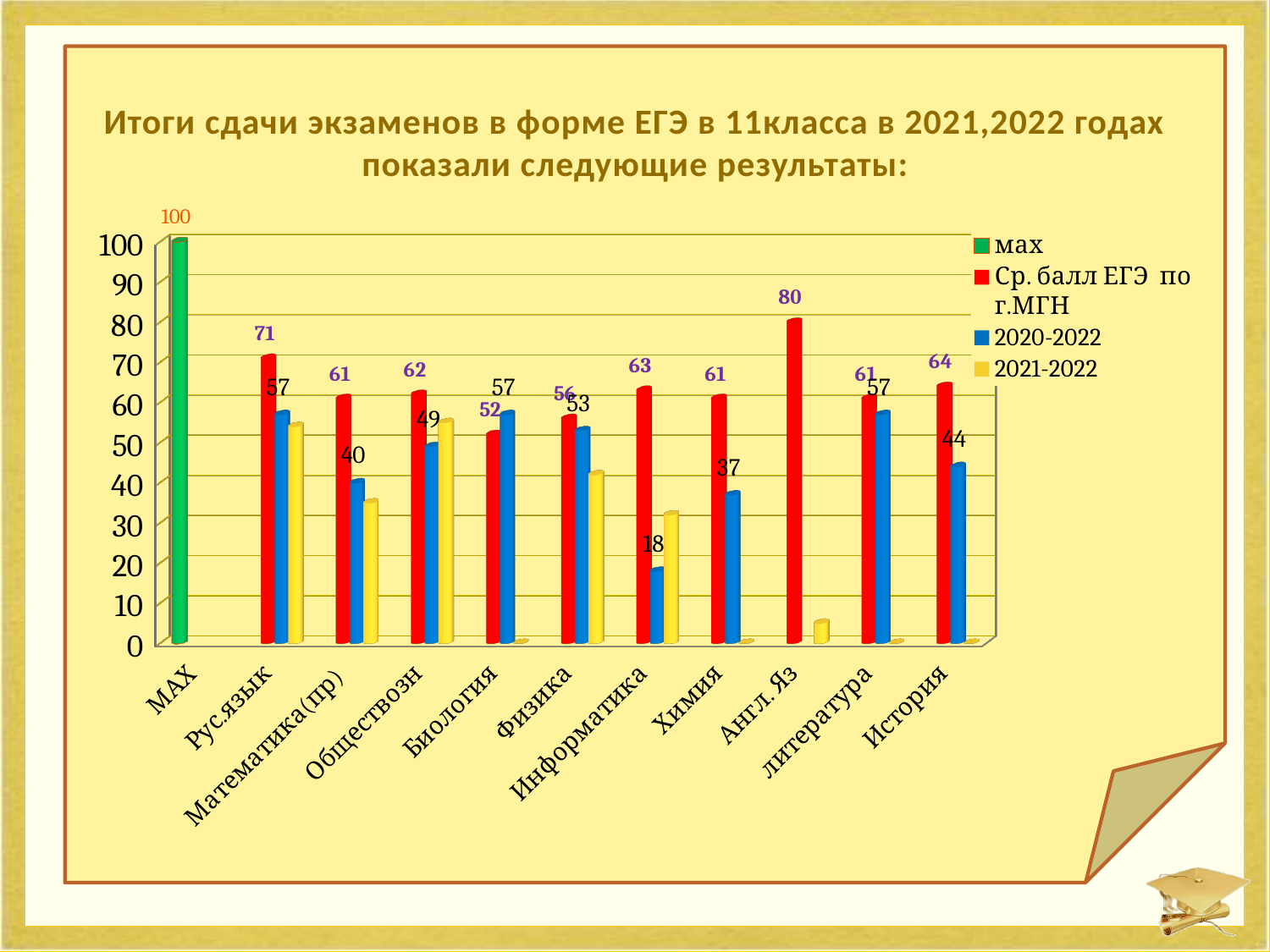
How many categories are shown on the x axis of the chart? 11 What is the value of the 'Ср. балл ЕГЭ по г.МГН' series for Рус.язык? 71 What is the value of the 'Ср. балл ЕГЭ по г.МГН' series for Англ.Яз? 80 For Рус.язык, what is the difference between the 'Ср. балл ЕГЭ по г.МГН' value and the '2020-2022' value? 14 How many series does the legend list? 4 For Химия, what is the difference between the 'Ср. балл ЕГЭ по г.МГН' value and the '2020-2022' value? 24 What is the value of the '2020-2022' series for Информатика? 18 Which subject has the highest value in the 'Ср. балл ЕГЭ по г.МГН' series? Англ.Яз Which subject has the lowest labelled value in the '2020-2022' series? Информатика What is the value of the '2020-2022' series for История? 44 For Биология, which series has the larger value: 'Ср. балл ЕГЭ по г.МГН' or '2020-2022'? 2020-2022 Is the '2021-2022' value for Информатика greater or less than 20? greater